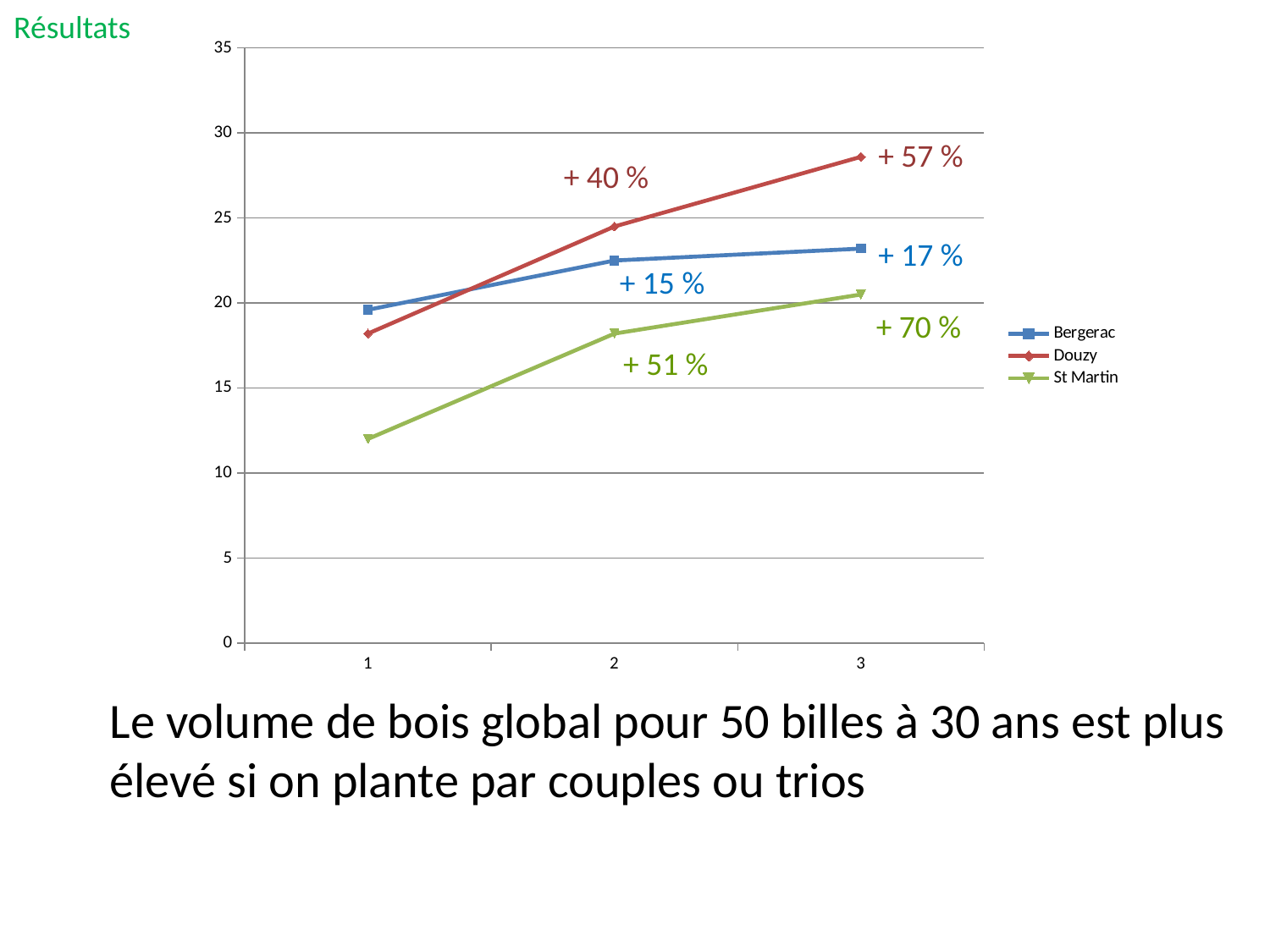
Is the value for St Martin at x = 1 greater or less than 15? less How many series does the legend list? 3 Is the value for Bergerac at x = 2 greater or less than 20? greater Which series has the highest value at x = 3? Douzy Is the value for Douzy at x = 3 greater or less than 25? greater Which series has the lowest value at x = 3? St Martin How many points are plotted along the x axis for each series? 3 What percentage increase is annotated next to the Douzy line at x = 3? + 57 % What kind of chart is shown on the slide? line chart At x = 2, which series has the larger value, Douzy or St Martin? Douzy Do the values for St Martin rise or fall from x = 1 to x = 3? rise Which series has the lowest value at x = 1? St Martin